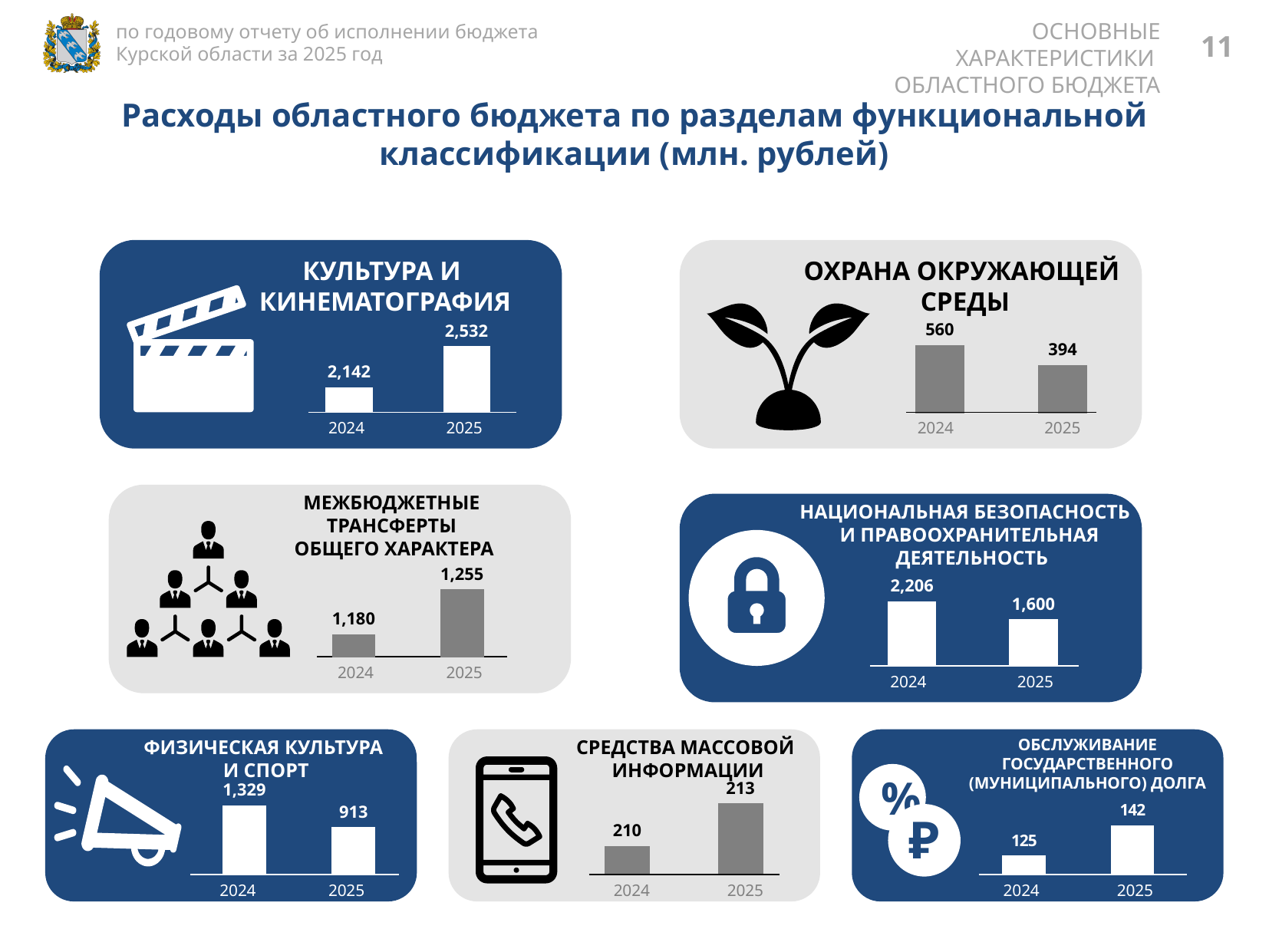
How many bars are shown in the chart "Национальная безопасность и правоохранительная деятельность"? 2 How many separate bar charts are shown on the slide? 7 In the chart "Средства массовой информации", what is the difference between the 2025 and 2024 values? 3 In the chart "Культура и кинематография", what is the value for 2025? 2,532 In the chart "Межбюджетные трансферты общего характера", what is the value for 2025? 1,255 In the chart "Обслуживание государственного (муниципального) долга", which year has the lower value? 2024 In the chart "Культура и кинематография", do the values rise or fall from 2024 to 2025? rise In the chart "Охрана окружающей среды", do the values rise or fall from 2024 to 2025? fall In the chart "Физическая культура и спорт", what is the difference between the 2024 and 2025 values? 416 In the chart "Охрана окружающей среды", what is the value for 2024? 560 What type of chart is used in the "Физическая культура и спорт" block? bar chart In the chart "Национальная безопасность и правоохранительная деятельность", which year has the higher value? 2024